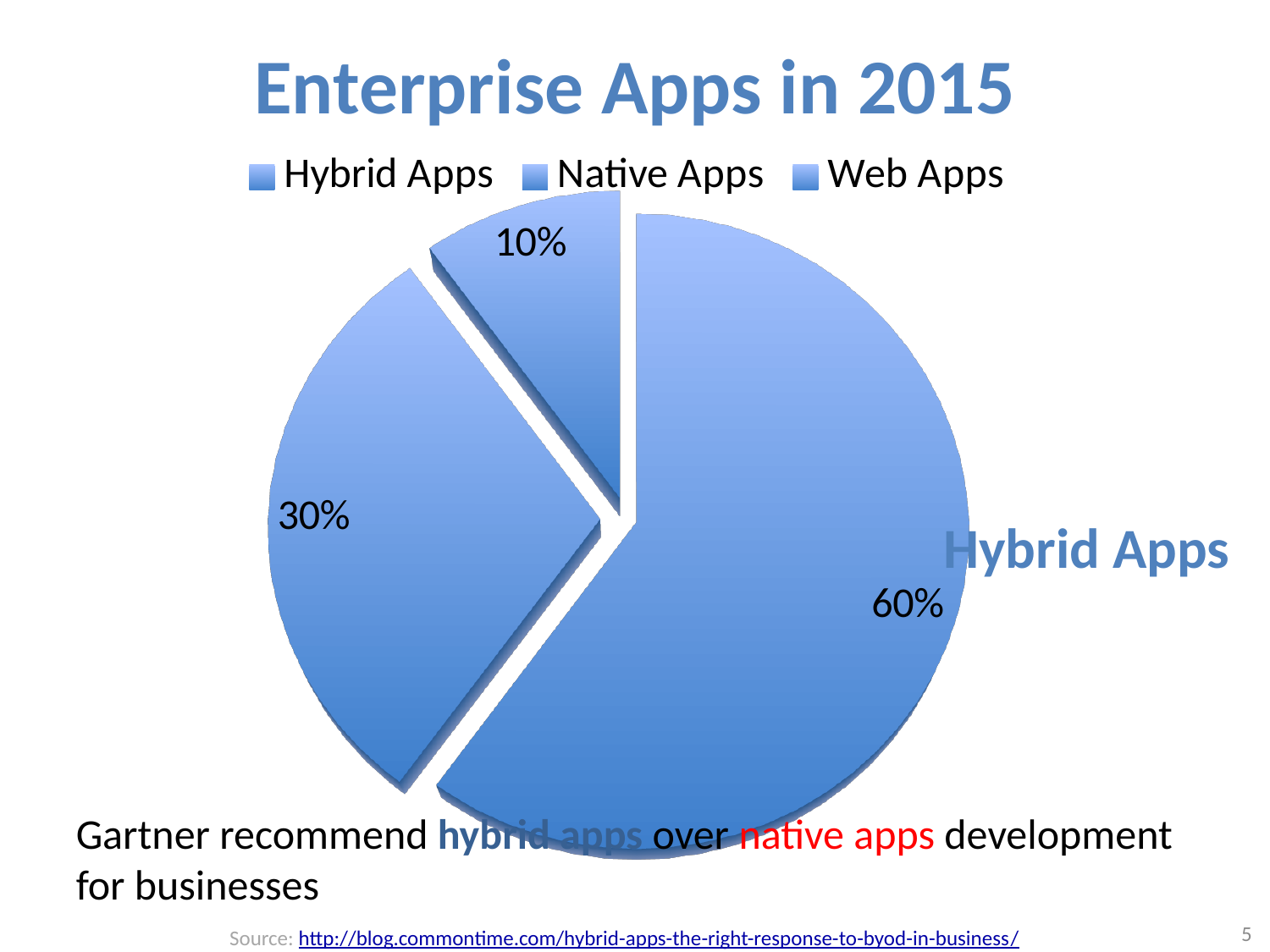
Which category has the largest slice of the pie? Hybrid Apps What is the title of the chart? Enterprise Apps in 2015 What is the difference between the 30% slice and the 10% slice? 20 percentage points What share of the pie is labelled Hybrid Apps? 60% What is the largest percentage shown on the pie chart? 60% What is the difference between the largest slice (60%) and the 30% slice? 30 percentage points Which three categories are listed in the chart legend? Hybrid Apps, Native Apps, Web Apps How many slices does the pie chart have? 3 Is the share for Hybrid Apps greater or less than 50%? greater What is the smallest percentage shown on the pie chart? 10% How many entries does the chart legend list? 3 What kind of chart is shown on the slide? pie chart